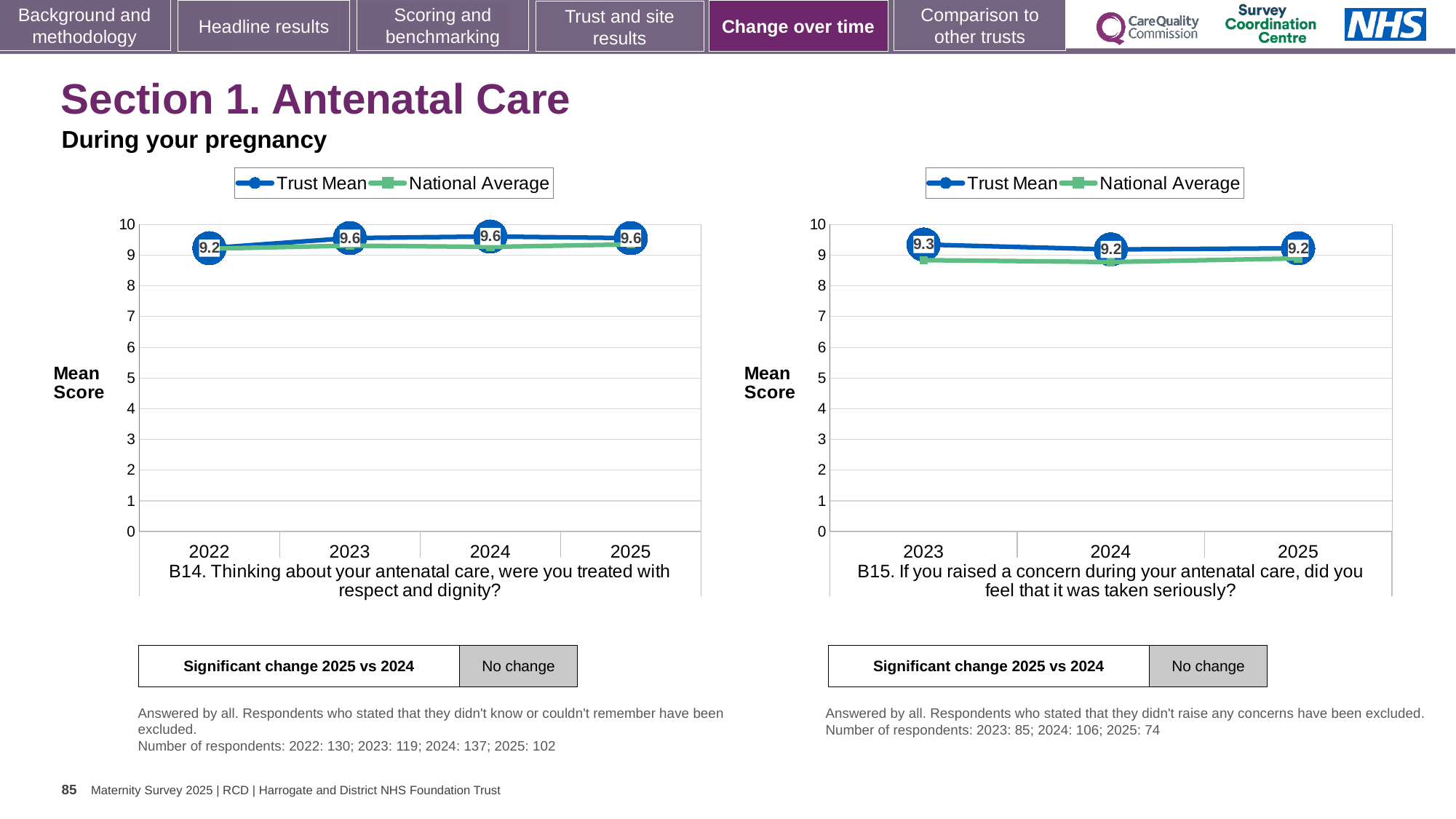
How many years are plotted on the x axis of the B14 chart on the left? 4 How many series does the legend of the B15 chart on the right list? 2 In the B15 chart on the right, which is larger in 2023, the Trust Mean or the National Average? Trust Mean What kind of chart is the B14 chart on the left? Line chart In the B15 chart on the right, which year has the highest Trust Mean score? 2023 In the B15 chart on the right, what is the Trust Mean score for 2024? 9.2 In the B14 chart on the left, what is the Trust Mean score for 2025? 9.6 In the B14 chart on the left, which year has the lowest Trust Mean score? 2022 In the B15 chart on the right, what is the Trust Mean score for 2023? 9.3 In the B14 chart on the left, by how much did the Trust Mean change from 2022 to 2023? 0.4 In the B14 chart on the left, what is the Trust Mean score for 2022? 9.2 In the B15 chart on the right, is the National Average for 2024 greater or less than 8? greater